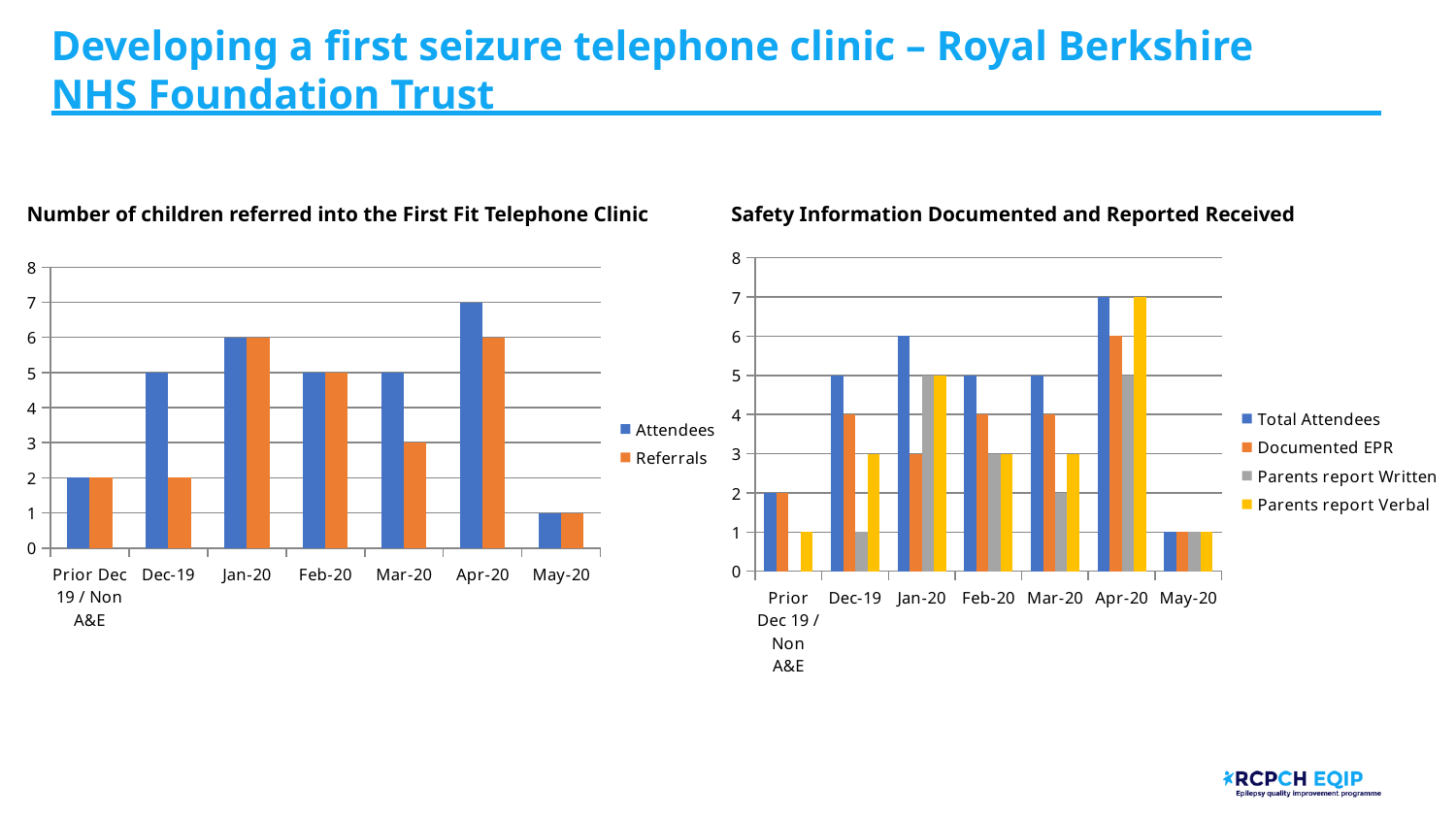
In the chart 'Number of children referred into the First Fit Telephone Clinic', what is the Attendees value for Apr-20? 7 What kind of chart is 'Number of children referred into the First Fit Telephone Clinic'? Bar chart In the chart 'Safety Information Documented and Reported Received', how many categories are shown on the x axis? 7 In the chart 'Safety Information Documented and Reported Received', is the Total Attendees value for Jan-20 larger or smaller than the Documented EPR value for Jan-20? Larger In the chart 'Number of children referred into the First Fit Telephone Clinic', which month has the highest Attendees value? Apr-20 In the chart 'Number of children referred into the First Fit Telephone Clinic', how many series does the legend list? 2 In the chart 'Safety Information Documented and Reported Received', which series has the lowest value for Dec-19? Parents report Written In the chart 'Safety Information Documented and Reported Received', what is the Parents report Written value for Jan-20? 5 In the chart 'Number of children referred into the First Fit Telephone Clinic', what is the difference between Attendees and Referrals for Dec-19? 3 In the chart 'Safety Information Documented and Reported Received', how many series does the legend list? 4 In the chart 'Number of children referred into the First Fit Telephone Clinic', what is the Referrals value for Mar-20? 3 In the chart 'Safety Information Documented and Reported Received', what is the Documented EPR value for Apr-20? 6